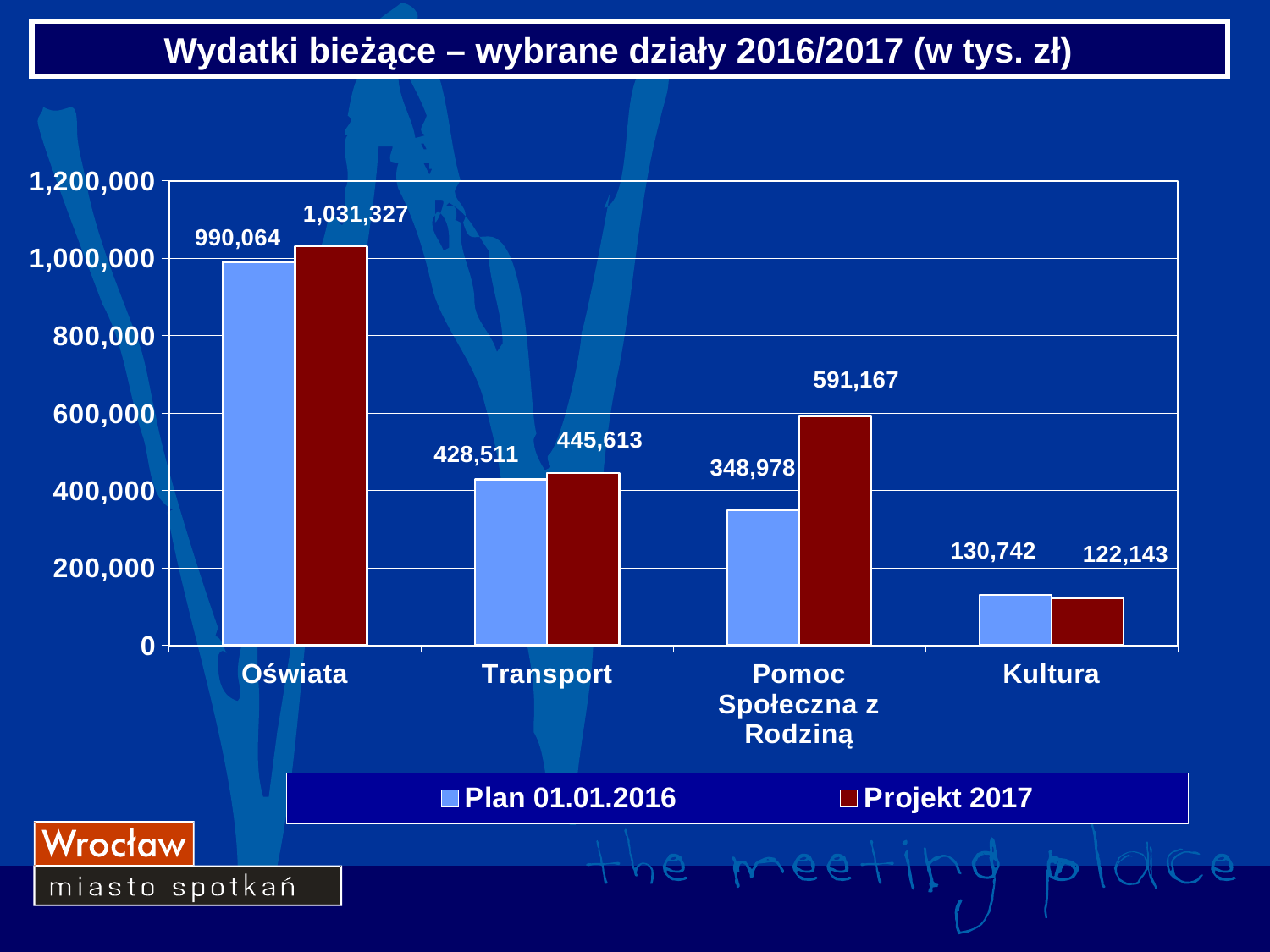
What type of chart is shown on the slide? Bar chart Which category has the highest Projekt 2017 value? Oświata For Transport, which is larger: Plan 01.01.2016 or Projekt 2017? Projekt 2017 What is the Projekt 2017 value for Pomoc Społeczna z Rodziną? 591,167 What is the difference between the Plan 01.01.2016 and Projekt 2017 values for Kultura? 8,599 Is the Projekt 2017 value for Oświata greater or less than 1,000,000? greater Which category has the lowest Plan 01.01.2016 value? Kultura What is the Plan 01.01.2016 value for Oświata? 990,064 What is the Projekt 2017 value for Kultura? 122,143 How many series does the legend list? 2 What is the difference between the Projekt 2017 and Plan 01.01.2016 values for Pomoc Społeczna z Rodziną? 242,189 How many categories are shown on the x axis? 4